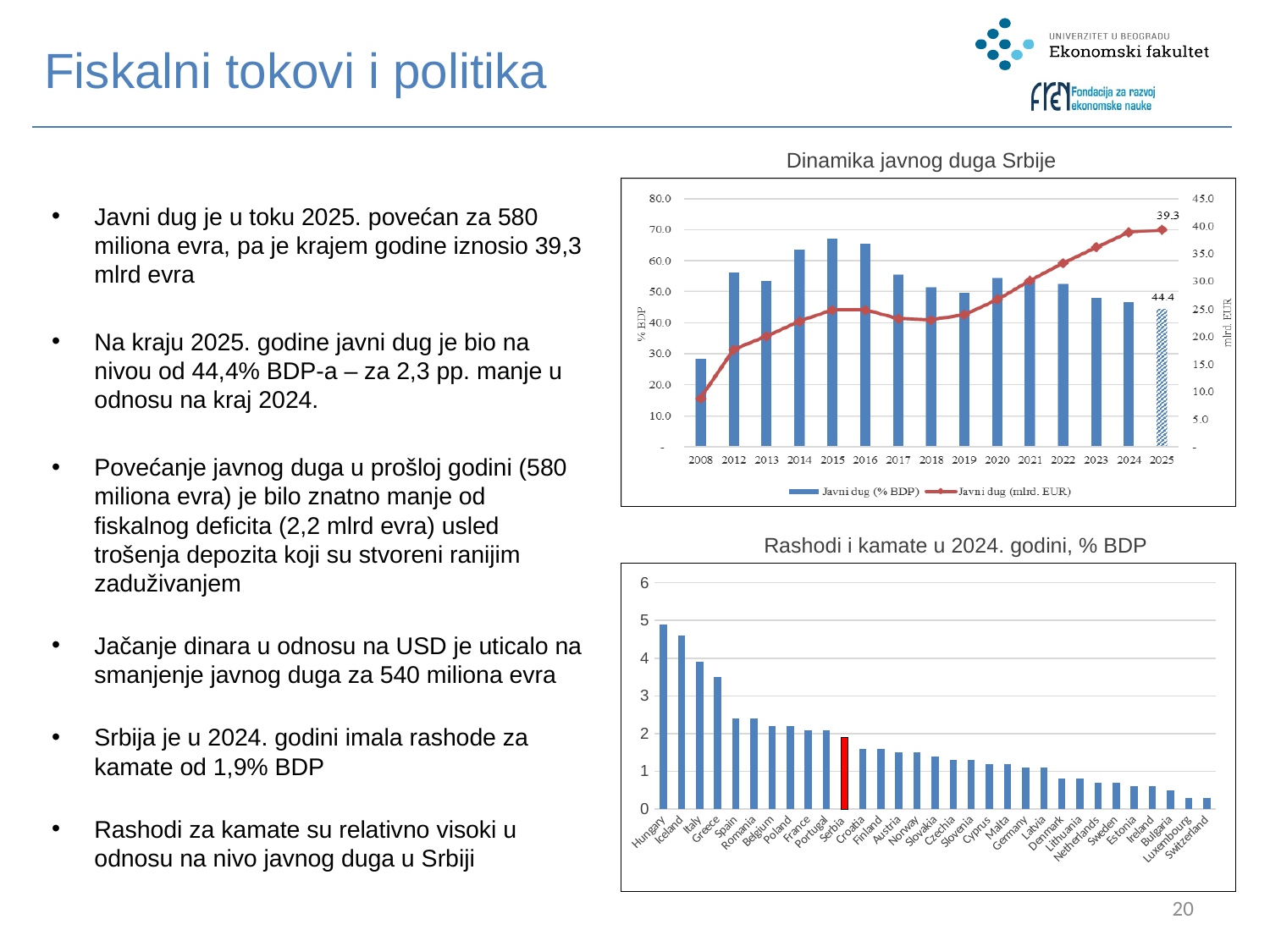
In the chart 'Dinamika javnog duga Srbije', how many series does the legend list? 2 In the chart 'Dinamika javnog duga Srbije', which year has the lowest bar for Javni dug (% BDP)? 2008 In the chart 'Dinamika javnog duga Srbije', how many years are shown on the x axis? 15 In the chart 'Rashodi i kamate u 2024. godini, % BDP', is the value for Hungary greater or less than 4? greater In the chart 'Dinamika javnog duga Srbije', does the line for Javni dug (mlrd. EUR) generally rise or fall from 2008 to 2025? rise In the chart 'Rashodi i kamate u 2024. godini, % BDP', which country's bar is coloured red? Serbia In the chart 'Dinamika javnog duga Srbije', what is the data label shown on the line point for 2025? 39.3 In the chart 'Rashodi i kamate u 2024. godini, % BDP', which has the larger value, Italy or Greece? Italy What kind of chart is 'Rashodi i kamate u 2024. godini, % BDP'? bar chart In the chart 'Rashodi i kamate u 2024. godini, % BDP', which country has the highest value? Hungary In the chart 'Dinamika javnog duga Srbije', what is the data label shown on the bar for 2025? 44.4 In the chart 'Dinamika javnog duga Srbije', is the bar value for 2014 greater or less than 60? greater